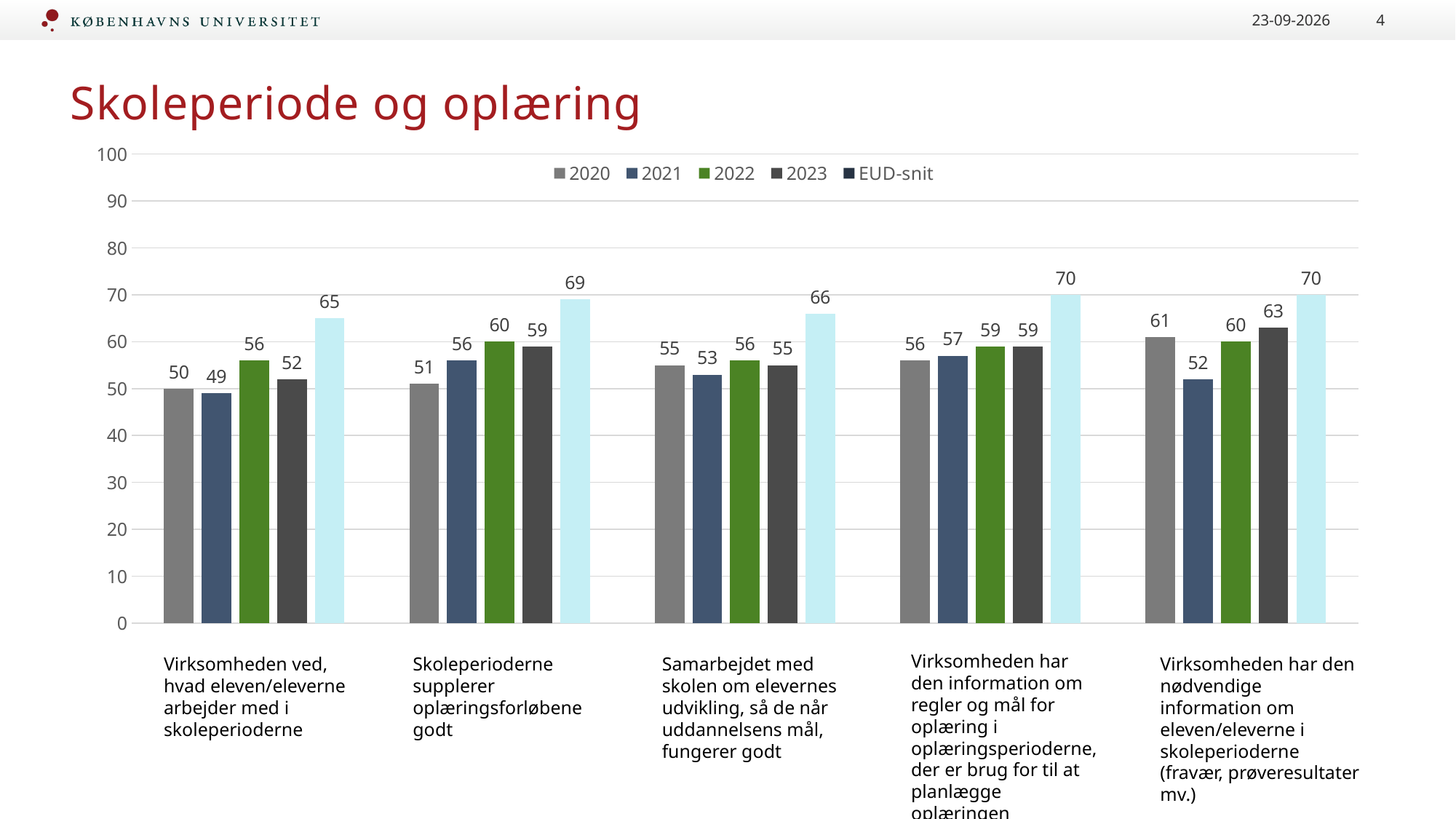
What is the difference between the EUD-snit value and the 2023 value for "Skoleperioderne supplerer oplæringsforløbene godt"? 10 What is the 2021 value for "Virksomheden har den nødvendige information om eleven/eleverne i skoleperioderne (fravær, prøveresultater mv.)"? 52 What is the EUD-snit value for "Virksomheden ved, hvad eleven/eleverne arbejder med i skoleperioderne"? 65 Which is larger for "Virksomheden har den nødvendige information om eleven/eleverne i skoleperioderne (fravær, prøveresultater mv.)": the 2020 value or the 2021 value? 2020 What is the 2022 value for "Skoleperioderne supplerer oplæringsforløbene godt"? 60 How many categories are shown on the x axis of the chart? 5 Which year series has the lowest value for "Virksomheden ved, hvad eleven/eleverne arbejder med i skoleperioderne"? 2021 Which series has the highest value for "Skoleperioderne supplerer oplæringsforløbene godt"? EUD-snit How many series does the legend list? 5 What is the 2023 value for "Samarbejdet med skolen om elevernes udvikling, så de når uddannelsens mål, fungerer godt"? 55 What is the title of the slide containing the chart? Skoleperiode og oplæring What kind of chart is shown on the slide? Bar chart